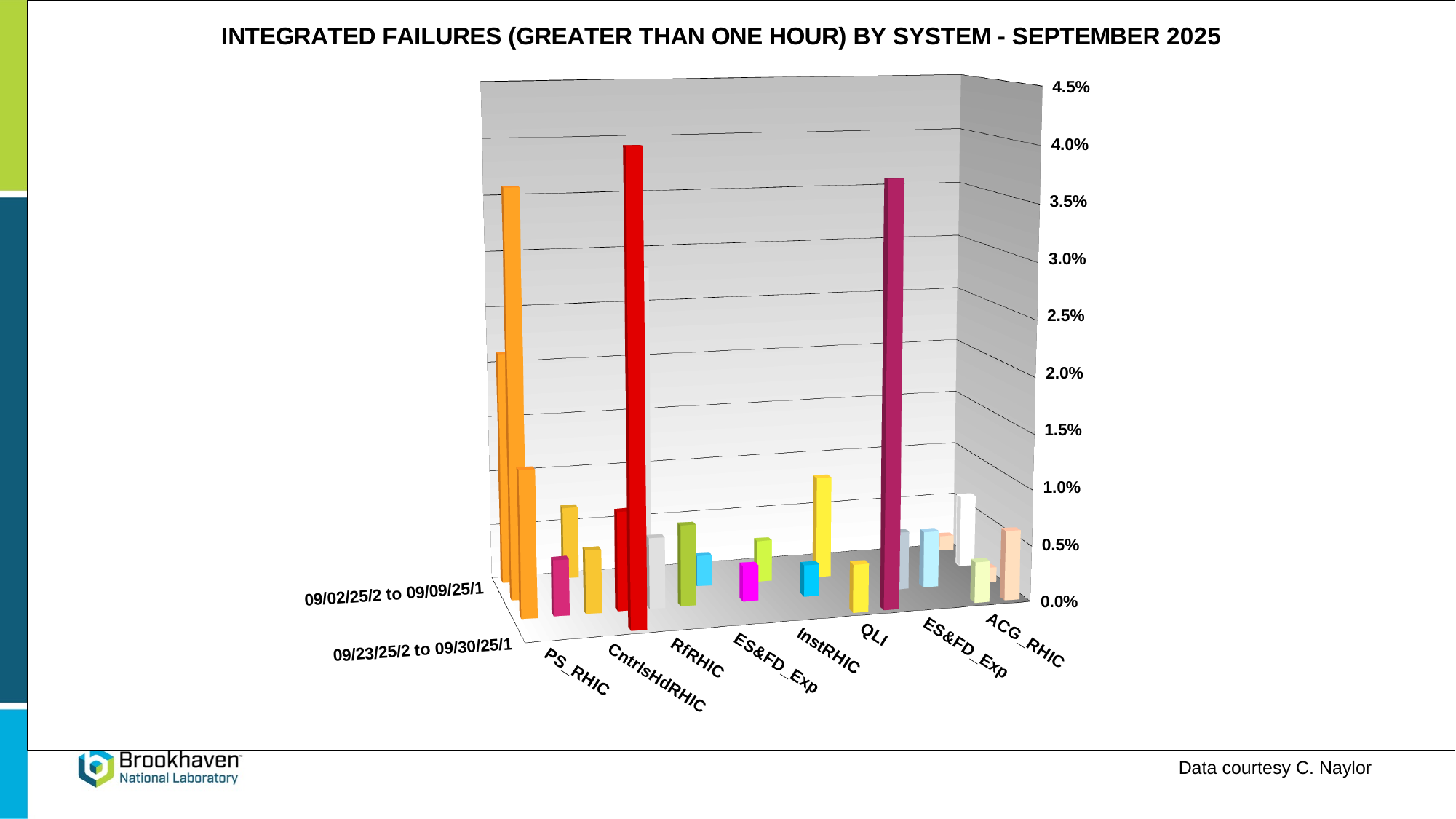
What kind of chart is shown on the slide? bar chart Is the tallest bar for PS_RHIC greater or less than 3.0%? greater How many system categories are labelled along the x axis of the chart? 8 Which has a taller maximum bar, PS_RHIC or RfRHIC? PS_RHIC Is the tallest bar for InstRHIC greater or less than 1.5%? less Is the tallest bar for ACG_RHIC greater or less than 1.0%? less What is the highest value shown on the vertical axis of the chart? 4.5% Which has a taller maximum bar, CntrlsHdRHIC or ES&FD_Exp? CntrlsHdRHIC What is the title of the chart? INTEGRATED FAILURES (GREATER THAN ONE HOUR) BY SYSTEM - SEPTEMBER 2025